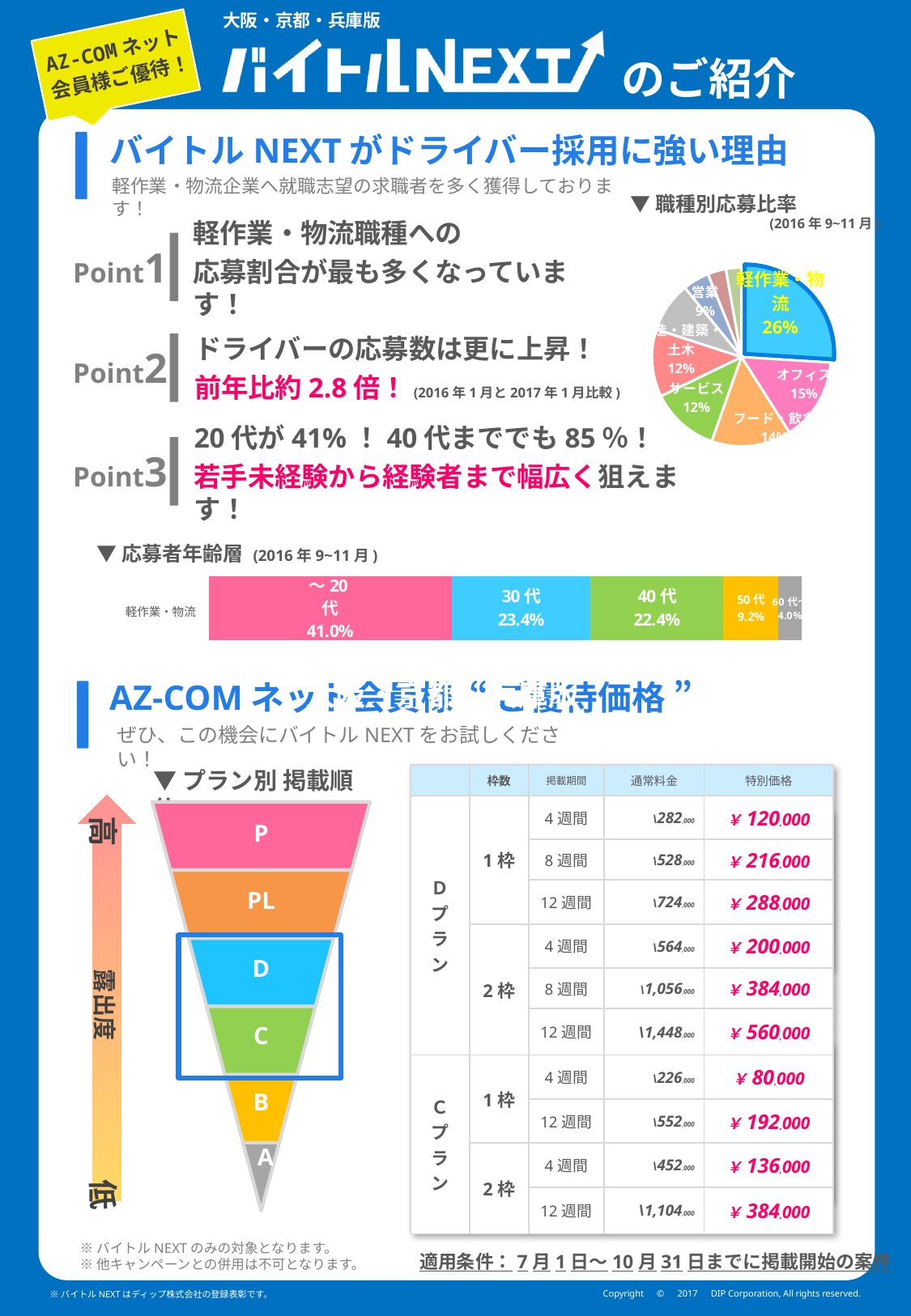
In the 応募者年齢層 bar chart, what is the value for 30代? 23.4% In the pie chart 職種別応募比率, which is larger, 軽作業・物流 or オフィス? 軽作業・物流 In the pie chart 職種別応募比率, which category has the largest share? 軽作業・物流 In the 応募者年齢層 bar chart, which age group has the smallest share? 60代～ In the pie chart 職種別応募比率, what is the value for 軽作業・物流? 26% In the pie chart 職種別応募比率, what is the value for 営業? 9% How many age-group segments are shown in the 応募者年齢層 bar chart? 5 In the 応募者年齢層 bar chart, what is the value for ～20代? 41.0% What kind of chart is the 職種別応募比率 chart? pie chart In the pie chart 職種別応募比率, what is the value for オフィス? 15% In the 応募者年齢層 bar chart, what is the difference between 30代 and 40代? 1.0% In the pie chart 職種別応募比率, what is the difference between 軽作業・物流 and オフィス? 11%